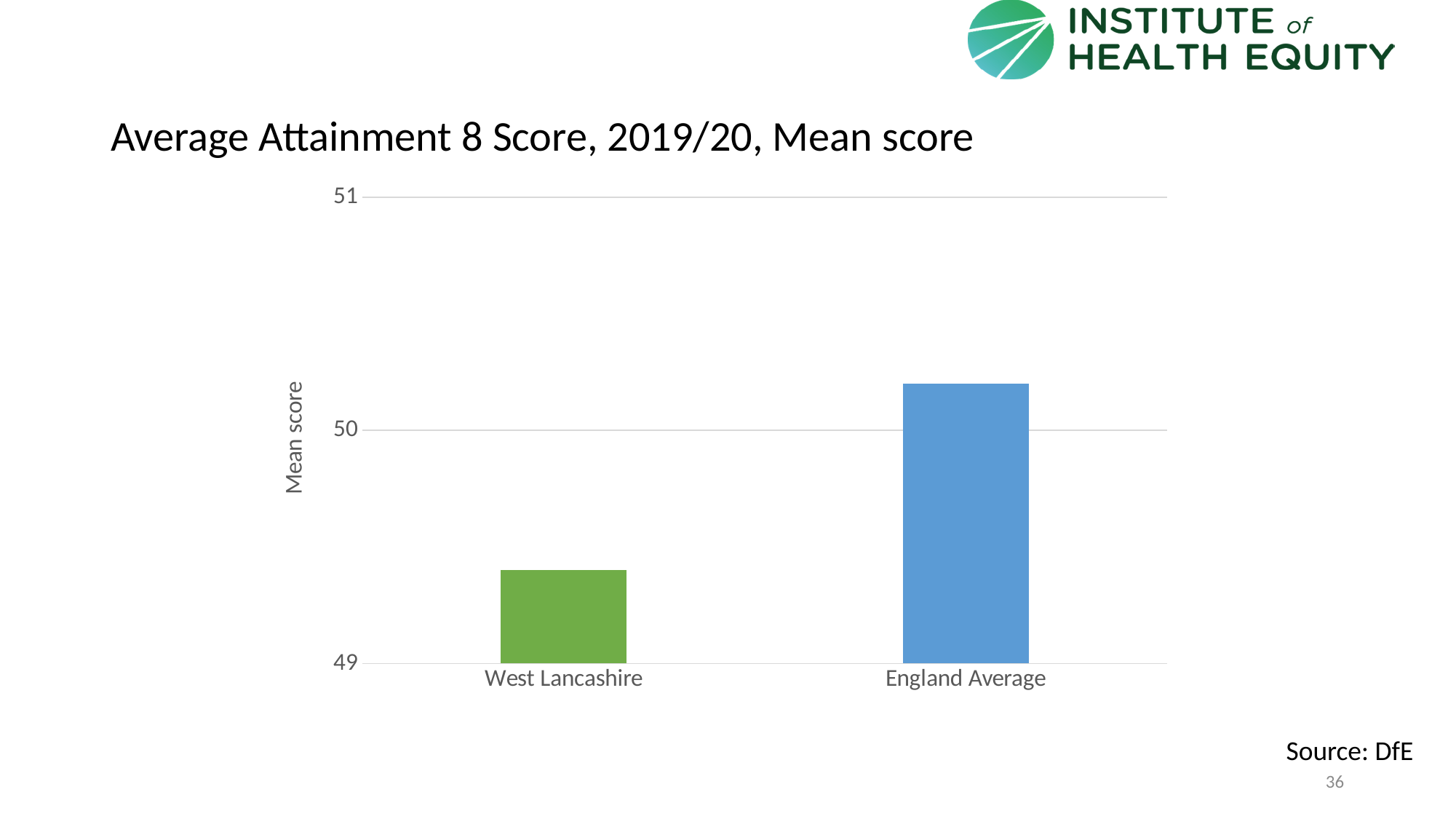
Is the value for West Lancashire greater or less than 49? greater How many categories are plotted in the chart? 2 Is the value for West Lancashire greater or less than 50? less Is the value for England Average greater or less than 51? less What is the label on the vertical axis? Mean score What kind of chart is shown on the slide? bar chart Which category has the lowest mean score? West Lancashire What is the title of the chart? Average Attainment 8 Score, 2019/20, Mean score Which is larger, the value for West Lancashire or the value for England Average? England Average Which category has the highest mean score? England Average